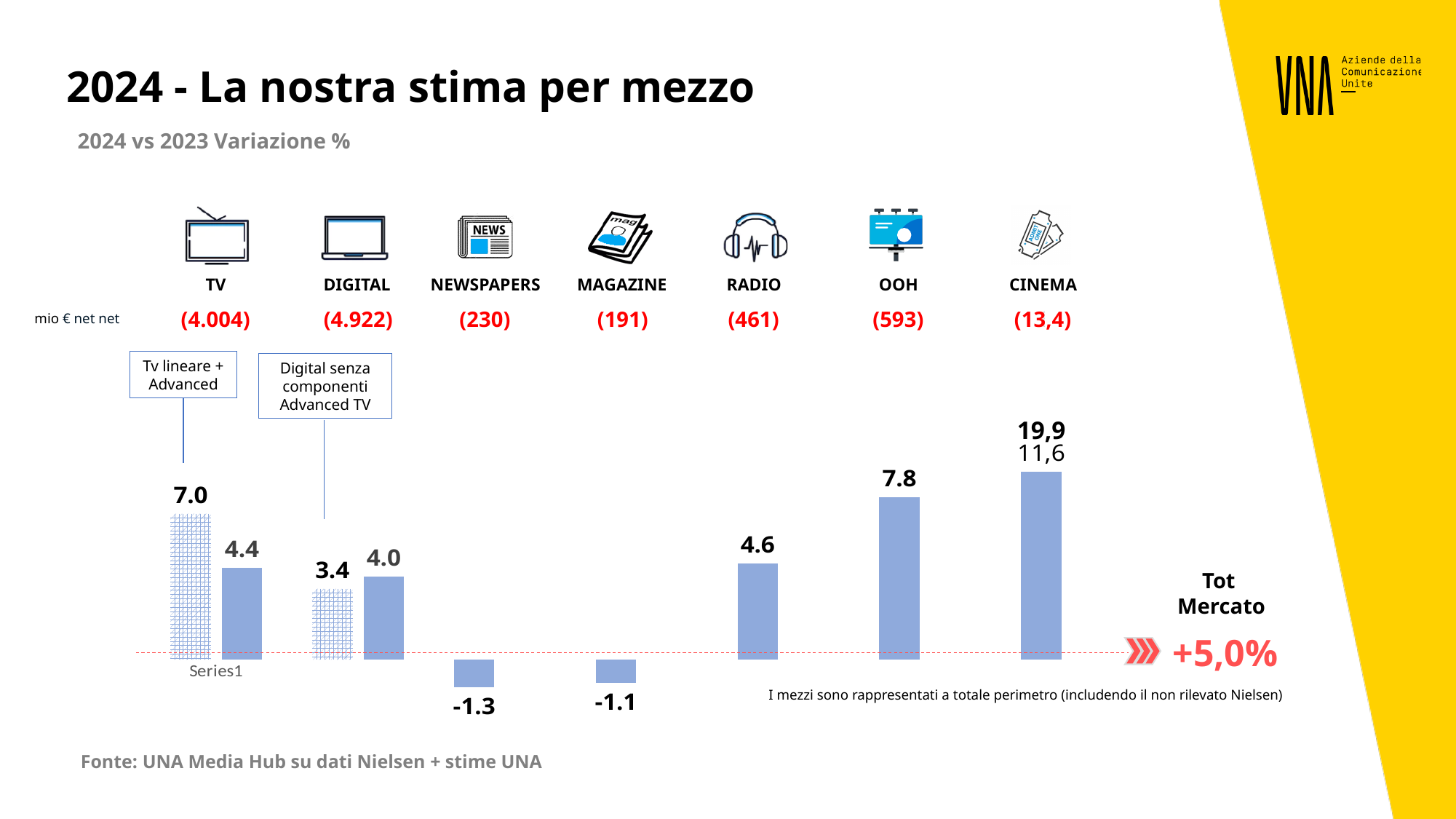
What is the 2024 vs 2023 variation % shown for RADIO? 4.6 How many media categories are shown in the chart? 7 What is the difference between the variation % for OOH and for RADIO? 3.2 What is the 2024 vs 2023 variation % shown for MAGAZINE? -1.1 What is the 2024 vs 2023 variation % shown for OOH? 7.8 What kind of chart is used on this slide? Bar chart What total market (Tot Mercato) variation is shown on the slide? +5,0% What value is labelled on the solid blue bar for TV? 4.4 Which medium has the lowest 2024 vs 2023 variation %? NEWSPAPERS Which medium has the highest 2024 vs 2023 variation %? CINEMA Which is larger: the variation % for RADIO or the solid blue bar for DIGITAL? RADIO What is the 2024 vs 2023 variation % shown for NEWSPAPERS? -1.3